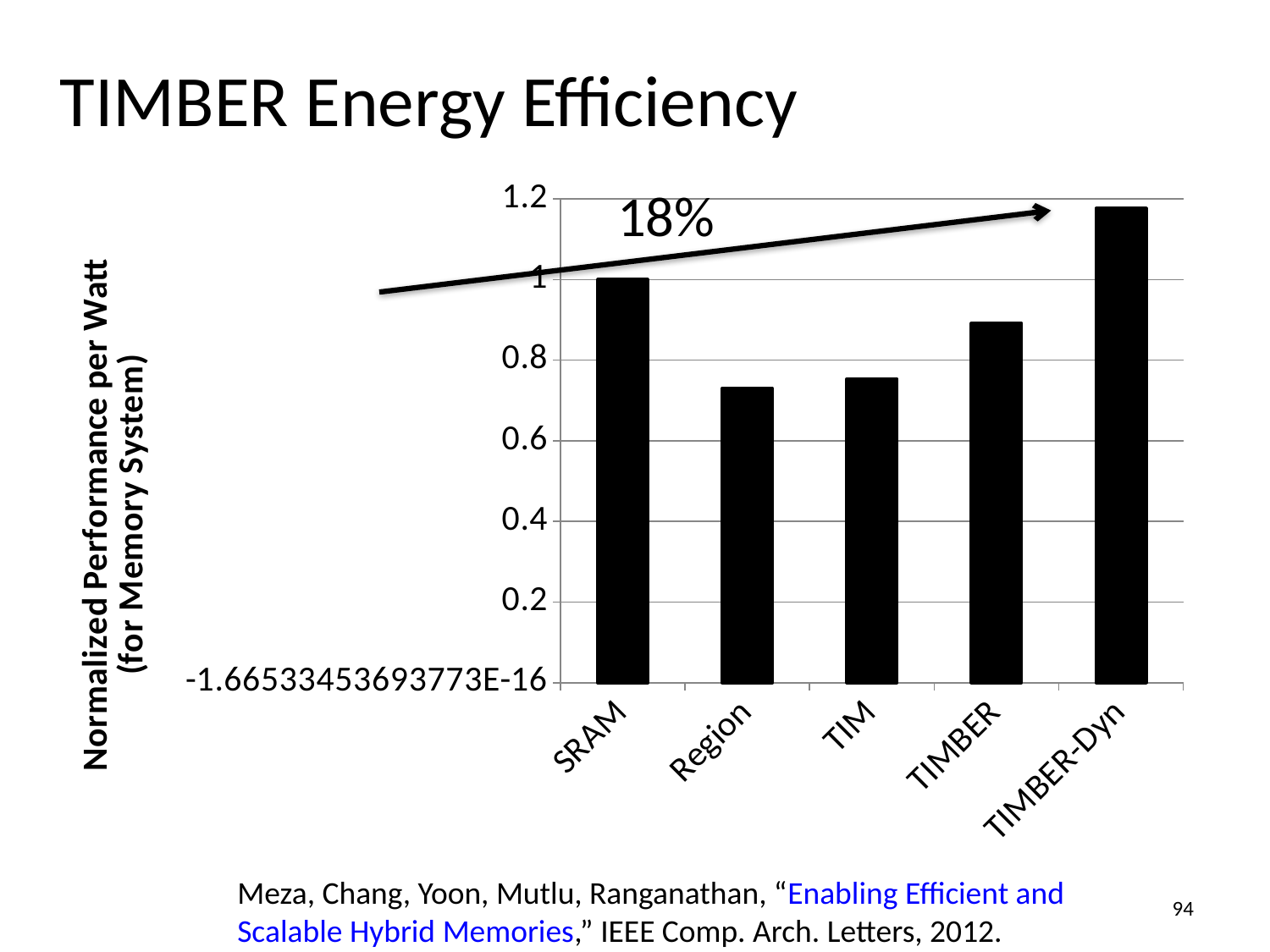
Is the value for Region greater or less than 0.8? less Is the value for TIMBER greater or less than 0.8? greater Is the value for TIMBER-Dyn greater or less than 1? greater What is the label of the y axis of the chart? Normalized Performance per Watt (for Memory System) What percentage improvement is annotated by the arrow on the chart? 18% Which category has the highest normalized performance per watt? TIMBER-Dyn What is the normalized performance per watt for SRAM? 1 Which has a higher normalized performance per watt, SRAM or TIMBER-Dyn? TIMBER-Dyn How many categories are plotted on the x axis of the chart? 5 What kind of chart is shown on the slide? bar chart Which has a higher normalized performance per watt, TIM or TIMBER? TIMBER